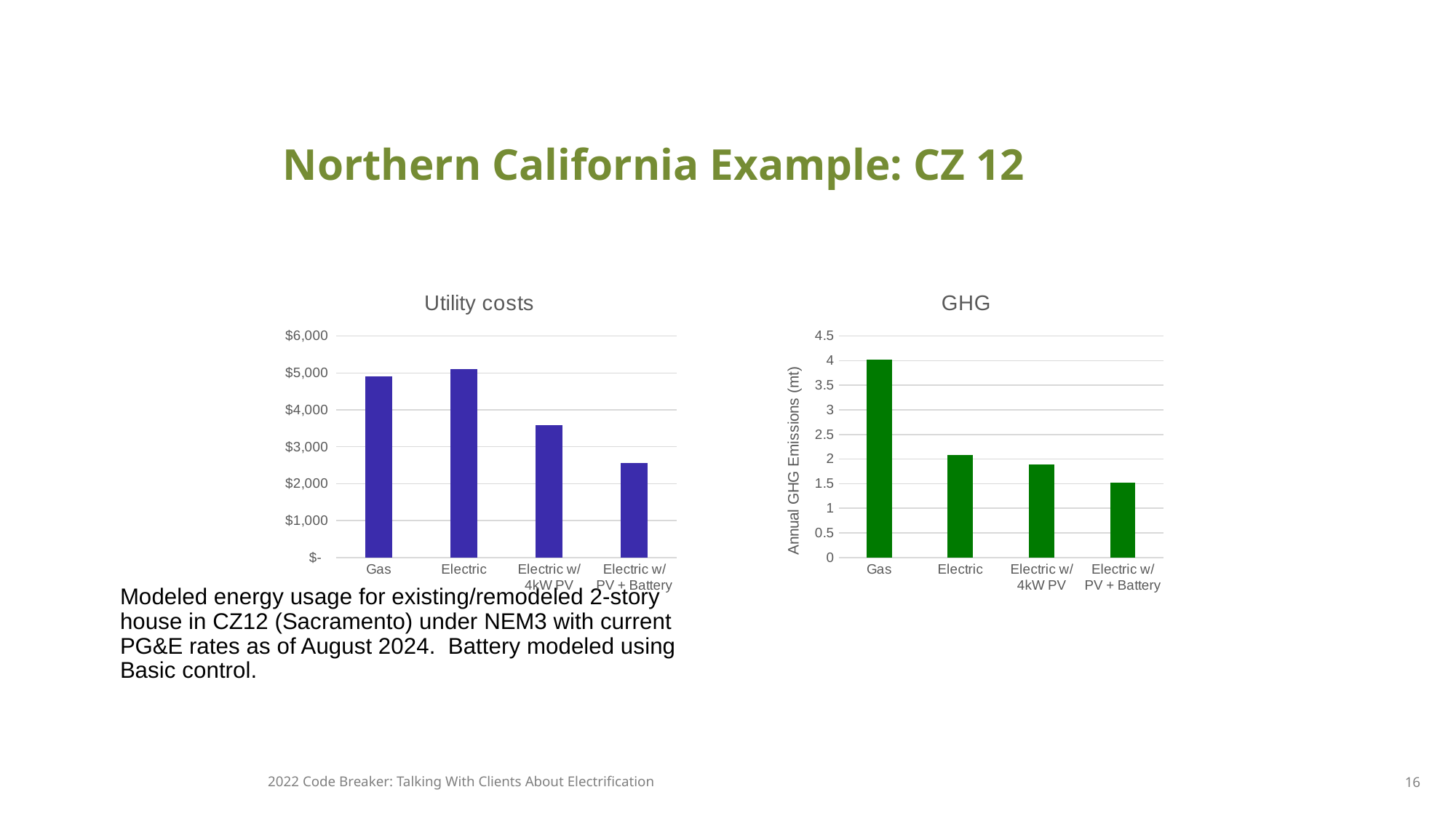
In the GHG chart, is the value for Gas greater or less than 3.5? greater In the GHG chart, is the value for Electric w/ PV + Battery greater or less than 2? less In the Utility costs chart, is the value for Electric w/ PV + Battery greater or less than $3,000? less What is the y-axis title of the GHG chart? Annual GHG Emissions (mt) In the GHG chart, do the values rise or fall from left to right along the x axis? fall In the GHG chart, which category has the lowest value? Electric w/ PV + Battery What kind of chart is the Utility costs chart? bar chart How many categories are shown on the GHG chart? 4 In the Utility costs chart, which category has the lowest value? Electric w/ PV + Battery In the GHG chart, which is larger, the value for Gas or the value for Electric? Gas In the GHG chart, which category has the highest value? Gas